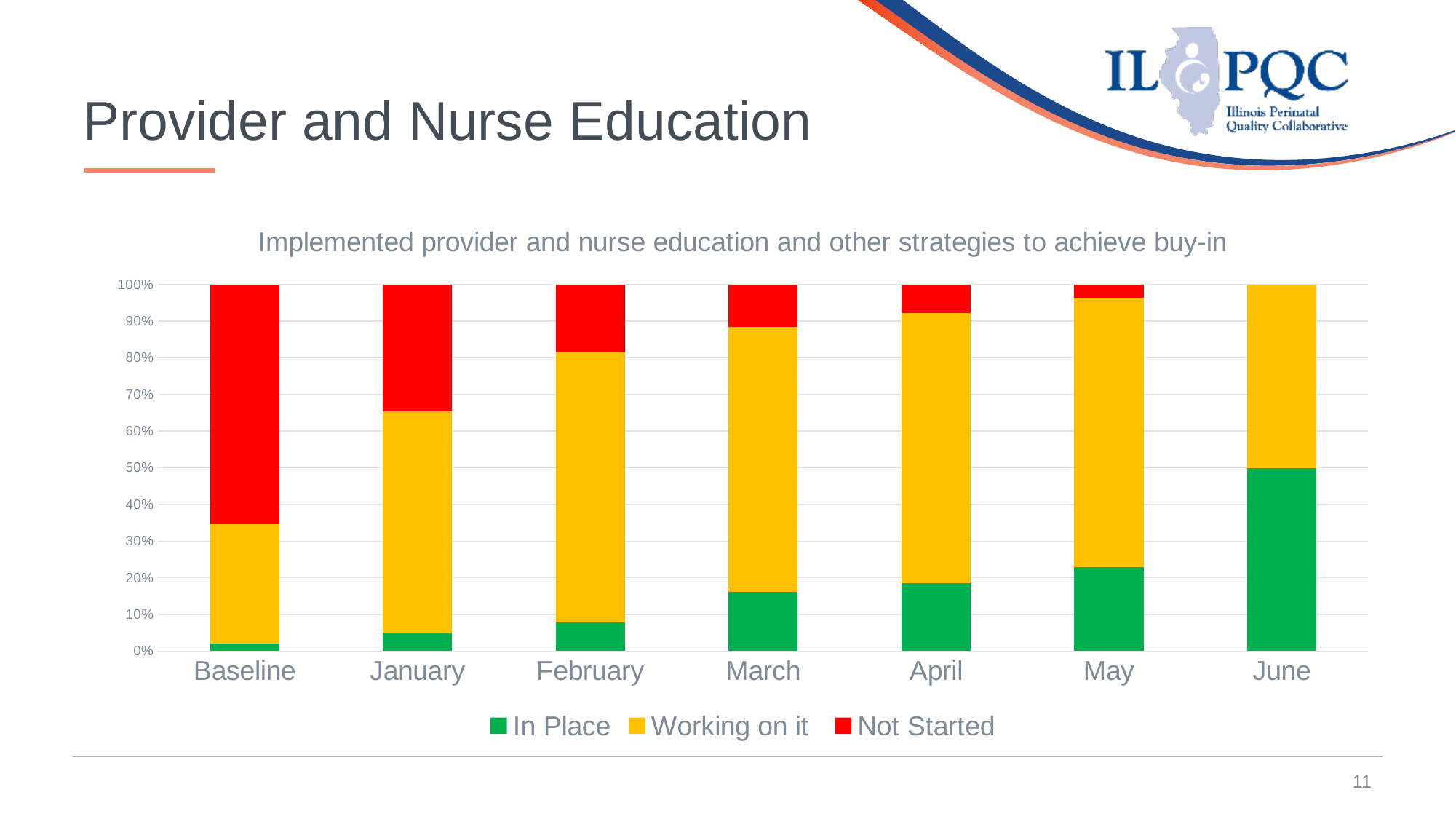
Does the 'Not Started' share rise or fall from Baseline to June? falls Which category has the largest 'In Place' share? June Which has the larger 'In Place' share, January or May? May Is the 'In Place' share for June greater or less than 40%? greater Is the 'Not Started' share for Baseline greater or less than 60%? greater What kind of chart is shown on the slide? Stacked bar chart How many categories are shown along the x axis of the chart? 7 How many series does the chart's legend list? 3 Which category has the largest 'Not Started' share? Baseline Does the 'In Place' share rise or fall from Baseline to June? rises What is the title of the chart? Implemented provider and nurse education and other strategies to achieve buy-in Which category has the smallest 'In Place' share? Baseline